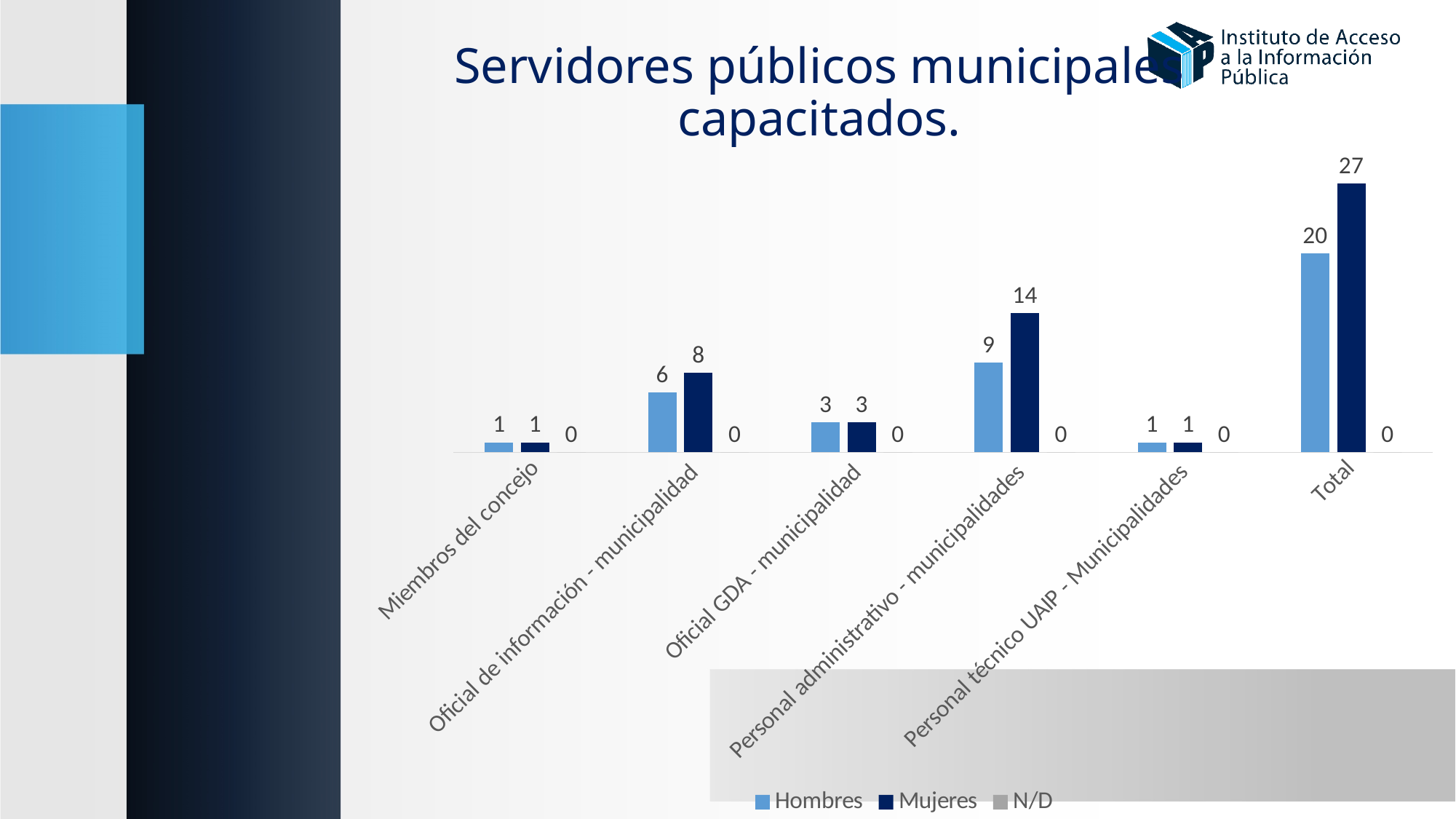
What is the title of the chart on the slide? Servidores públicos municipales capacitados. What is the value for Hombres in the Personal administrativo - municipalidades category? 9 What is the difference between Mujeres and Hombres in the Personal administrativo - municipalidades category? 5 What is the difference between Mujeres and Hombres in the Total category? 7 What is the value for N/D in the Oficial GDA - municipalidad category? 0 What kind of chart is shown on the slide? Bar chart How many categories are shown on the x axis? 6 What is the value for Mujeres in the Total category? 27 What is the value for Mujeres in the Oficial de información - municipalidad category? 8 How many series does the legend list? 3 Which is larger in the Oficial de información - municipalidad category, Hombres or Mujeres? Mujeres Excluding Total, which category has the highest value for Mujeres? Personal administrativo - municipalidades